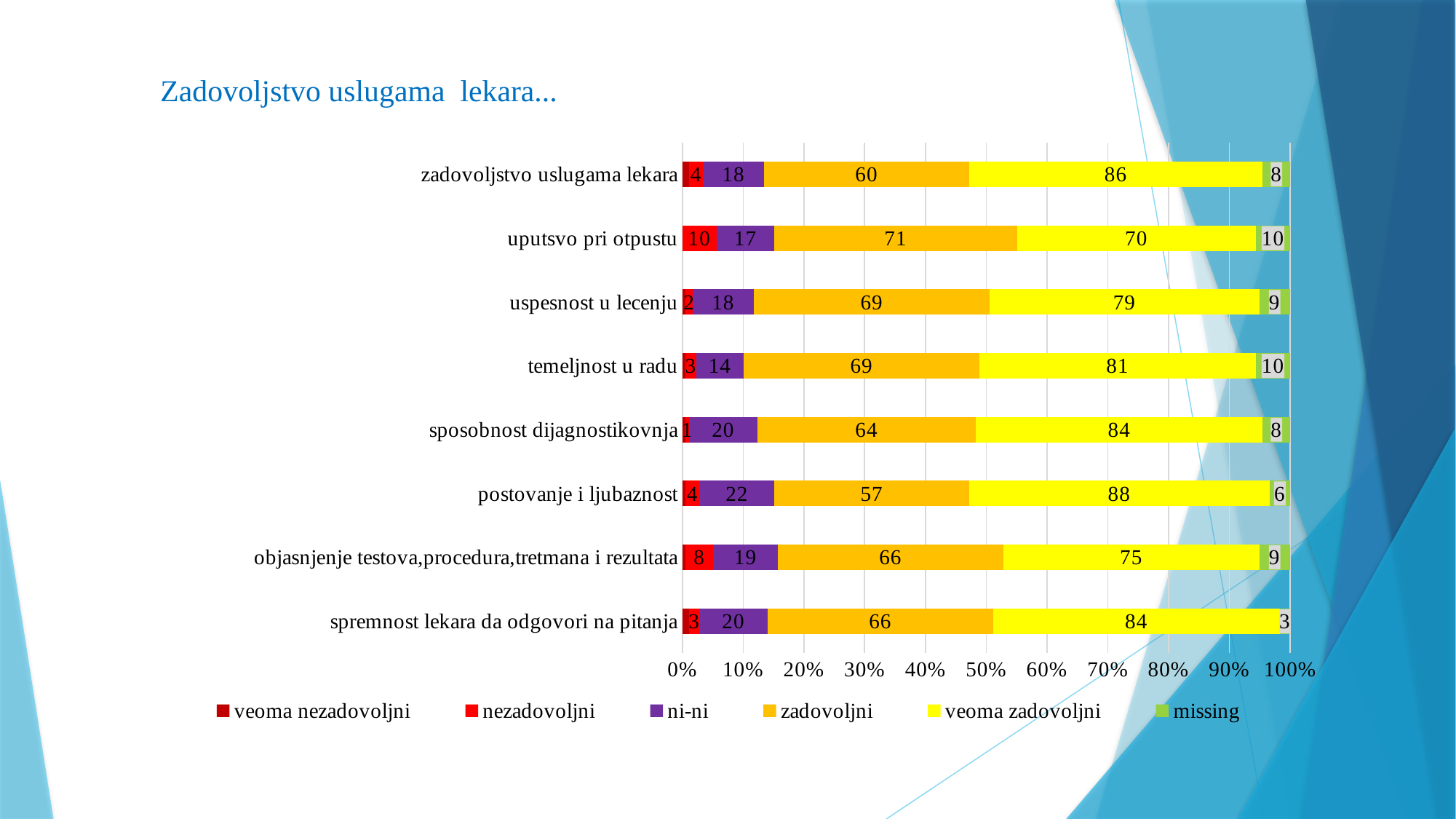
Which has the larger 'ni-ni' value: 'postovanje i ljubaznost' or 'temeljnost u radu'? postovanje i ljubaznost What is the 'veoma zadovoljni' value for 'postovanje i ljubaznost'? 88 What is the title of the slide? Zadovoljstvo uslugama lekara... For 'zadovoljstvo uslugama lekara', what is the difference between the 'veoma zadovoljni' and 'zadovoljni' values? 26 How many series does the legend list? 6 Which category has the lowest 'veoma zadovoljni' value? uputsvo pri otpustu What is the 'zadovoljni' value for 'uputsvo pri otpustu'? 71 Which category has the highest 'zadovoljni' value? uputsvo pri otpustu What type of chart is shown on the slide? Stacked bar chart Which category has the highest 'veoma zadovoljni' value? postovanje i ljubaznost What is the 'ni-ni' value for 'sposobnost dijagnostikovnja'? 20 How many categories are plotted on the chart? 8